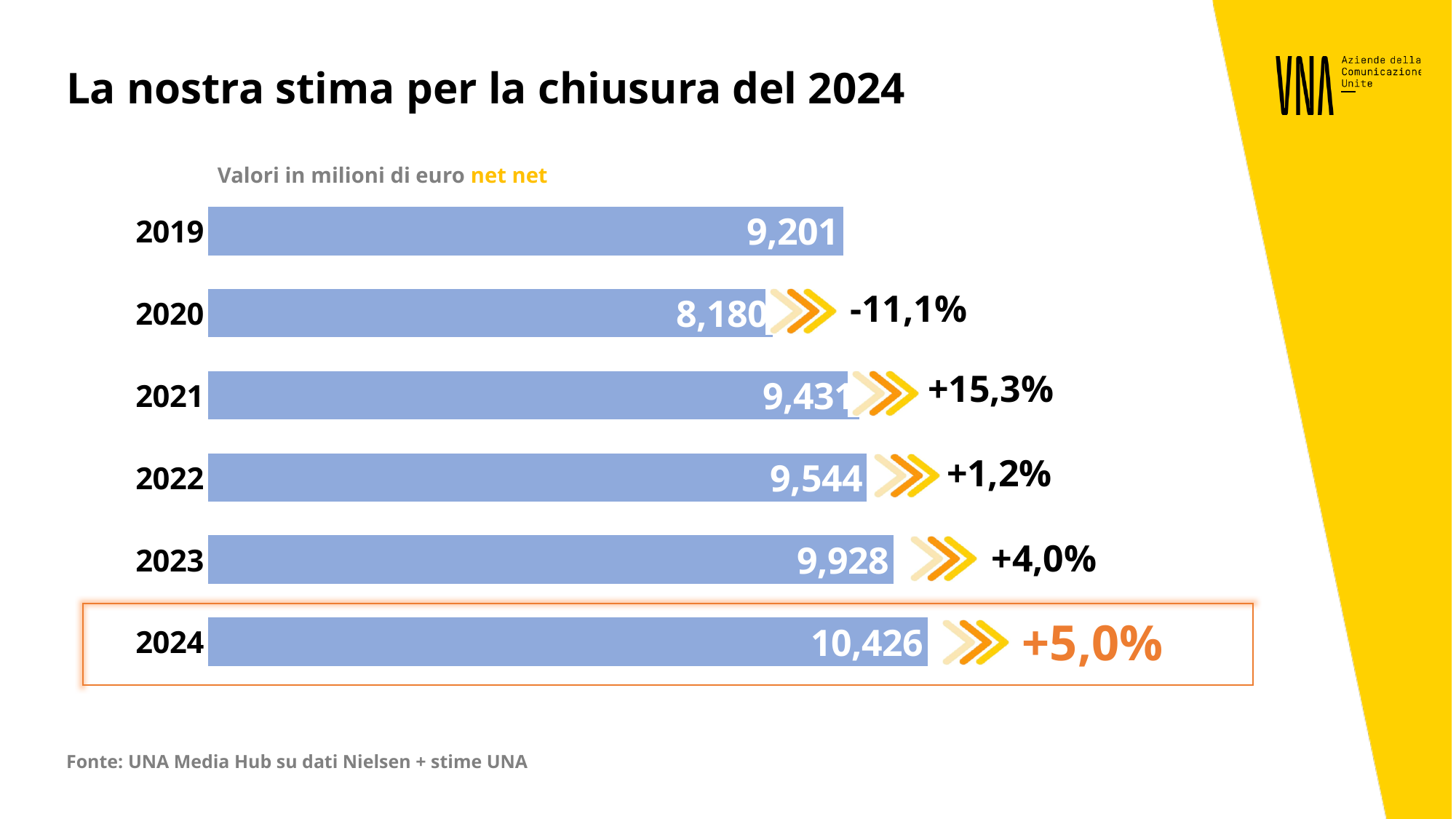
What percentage change is shown next to the 2021 bar? +15,3% What is the subtitle above the chart describing the units? Valori in milioni di euro net net What is the value for 2024? 10,426 Which year has the lowest value? 2020 What kind of chart is shown on the slide? Bar chart What is the difference between the values for 2024 and 2023? 498 Which is larger, the value for 2021 or the value for 2022? 2022 What is the value for 2020? 8,180 What is the value for 2019? 9,201 What is the difference between the values for 2019 and 2020? 1,021 Which year has the highest value? 2024 How many years are shown in the chart? 6